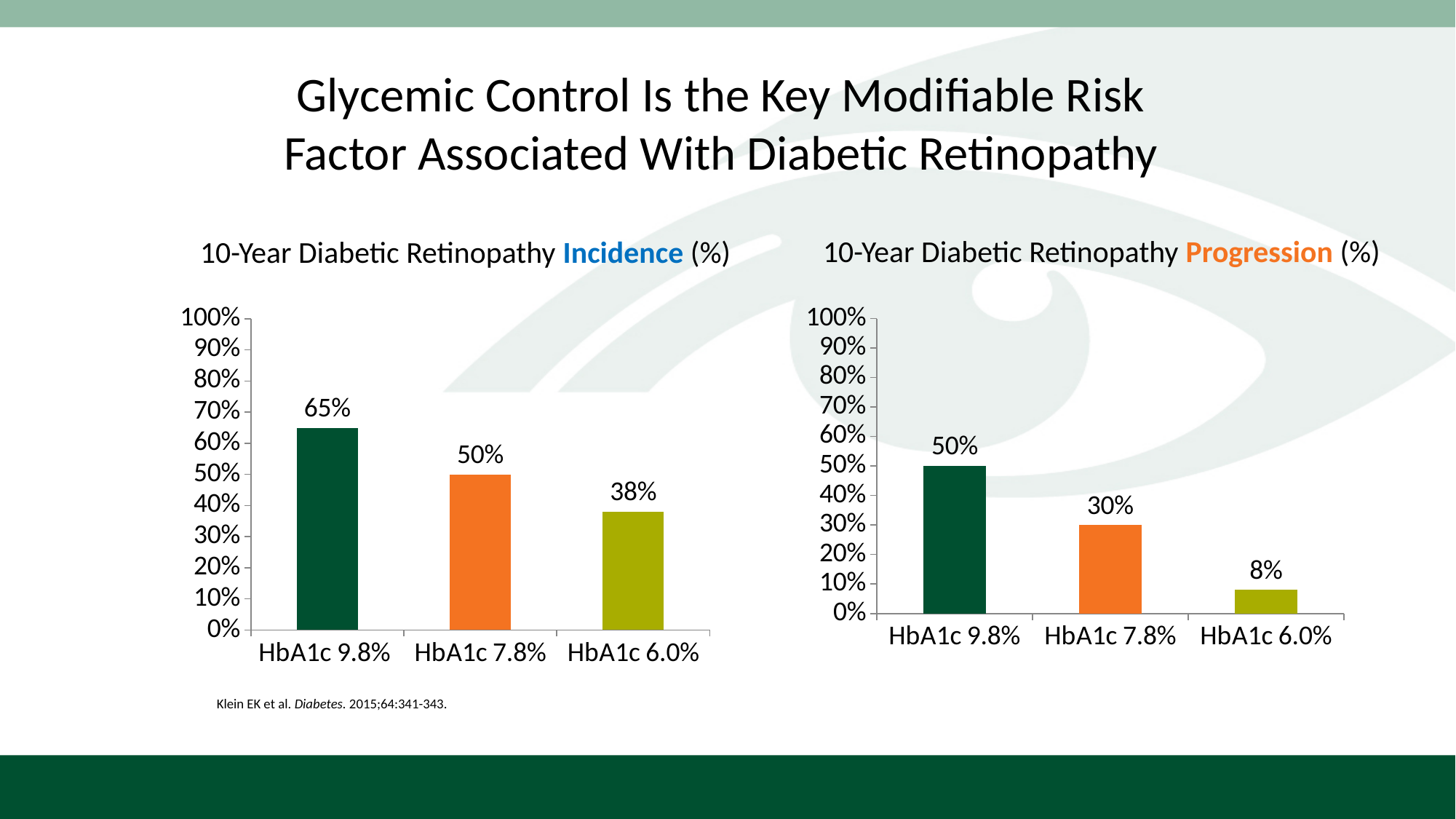
In the 10-Year Diabetic Retinopathy Incidence (%) chart, what is the value for HbA1c 9.8%? 65% What kind of chart is the 10-Year Diabetic Retinopathy Incidence (%) chart? Bar chart In the 10-Year Diabetic Retinopathy Incidence (%) chart, do the values rise or fall from HbA1c 9.8% to HbA1c 6.0%? Fall How many categories are shown in the 10-Year Diabetic Retinopathy Progression (%) chart? 3 In the 10-Year Diabetic Retinopathy Progression (%) chart, which category has the lowest value? HbA1c 6.0% In the 10-Year Diabetic Retinopathy Progression (%) chart, what is the value for HbA1c 7.8%? 30% In the 10-Year Diabetic Retinopathy Progression (%) chart, what is the difference between the values for HbA1c 9.8% and HbA1c 6.0%? 42% Which is larger: the HbA1c 7.8% value in the Incidence chart or the HbA1c 7.8% value in the Progression chart? Incidence chart In the 10-Year Diabetic Retinopathy Progression (%) chart, what is the value for HbA1c 6.0%? 8% In the 10-Year Diabetic Retinopathy Incidence (%) chart, what is the value for HbA1c 6.0%? 38% In the 10-Year Diabetic Retinopathy Incidence (%) chart, which category has the highest value? HbA1c 9.8% In the 10-Year Diabetic Retinopathy Incidence (%) chart, what is the difference between the values for HbA1c 9.8% and HbA1c 7.8%? 15%